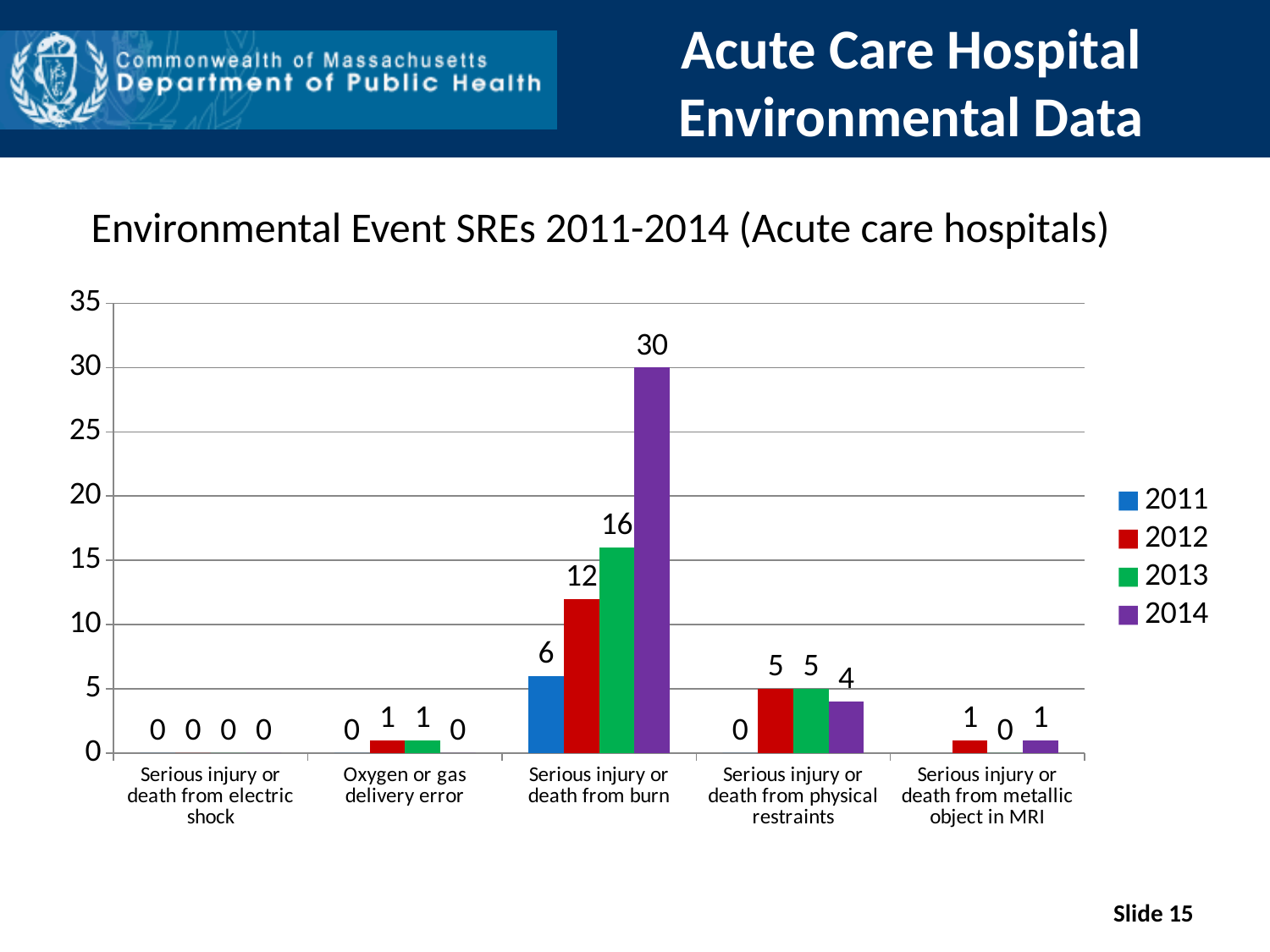
What is the value for 2014 in the 'Serious injury or death from burn' category? 30 What kind of chart is shown on the slide? Bar chart Which is larger for 'Serious injury or death from physical restraints': the 2012 value or the 2014 value? 2012 What is the difference between the 2014 and 2013 values for 'Serious injury or death from burn'? 14 How many categories are shown on the x axis? 5 What is the value for 2012 in the 'Oxygen or gas delivery error' category? 1 What is the value for 2013 in the 'Serious injury or death from physical restraints' category? 5 What is the value for 2011 in the 'Serious injury or death from burn' category? 6 Which category has the highest value for 2014? Serious injury or death from burn Do the values for 'Serious injury or death from burn' rise or fall from 2011 to 2014? Rise Is the 2014 value for 'Serious injury or death from burn' greater or less than 25? greater How many series does the legend list? 4